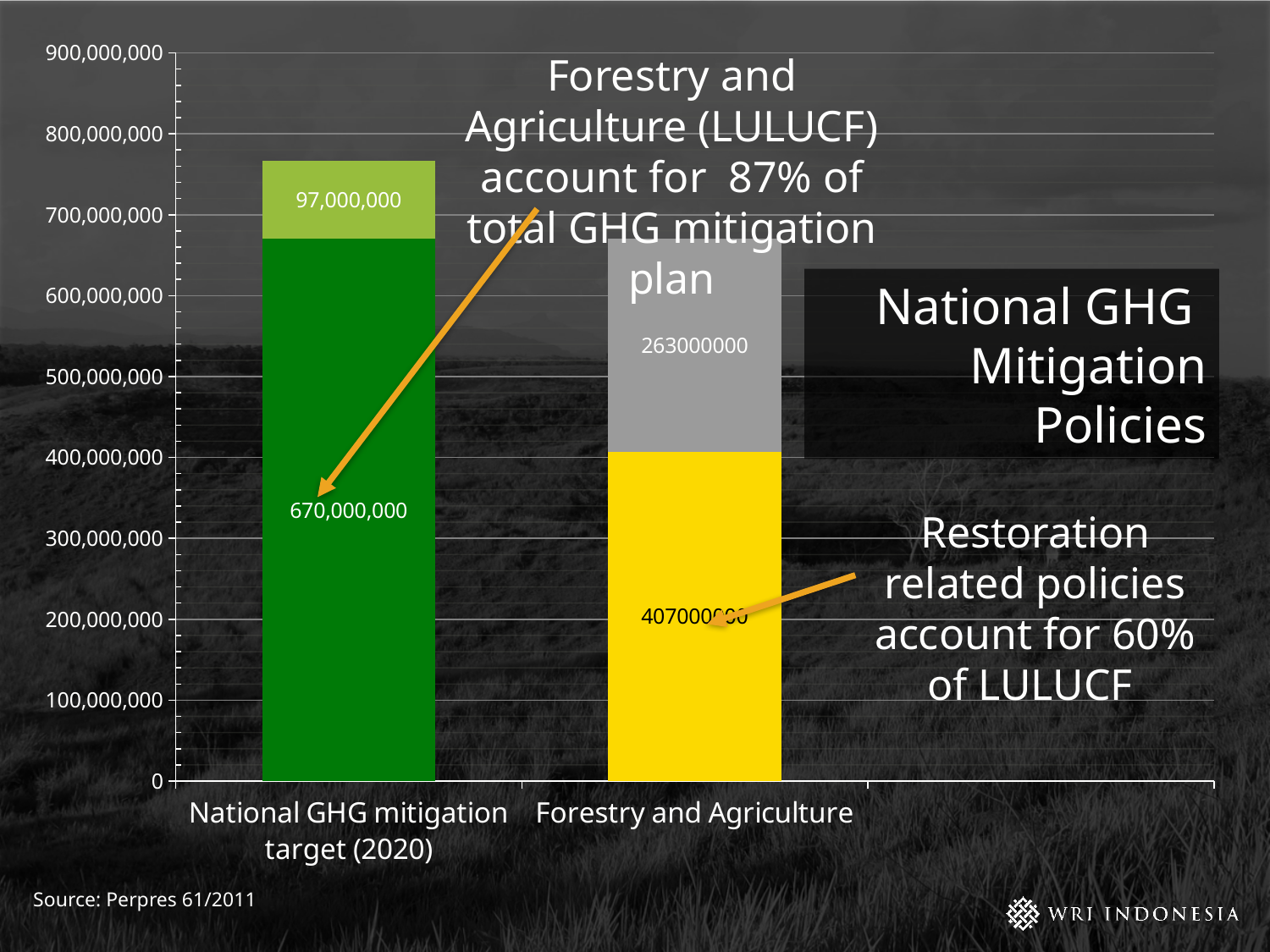
How many categories are shown on the x axis of the chart? 2 What is the value of the yellow bottom segment of the Forestry and Agriculture bar? 407000000 What source is cited for the chart data? Perpres 61/2011 What is the value of the light green top segment of the National GHG mitigation target (2020) bar? 97,000,000 What is the value of the dark green bottom segment of the National GHG mitigation target (2020) bar? 670,000,000 Which stacked bar is taller overall, National GHG mitigation target (2020) or Forestry and Agriculture? National GHG mitigation target (2020) What is the difference between the yellow segment (407000000) and the grey segment (263000000) of the Forestry and Agriculture bar? 144,000,000 What is the value of the grey top segment of the Forestry and Agriculture bar? 263000000 What kind of chart is shown on the slide? Stacked bar chart Is the total of the Forestry and Agriculture bar greater or less than 700,000,000? less What is the total of the stacked Forestry and Agriculture bar? 670,000,000 What is the total of the stacked National GHG mitigation target (2020) bar? 767,000,000